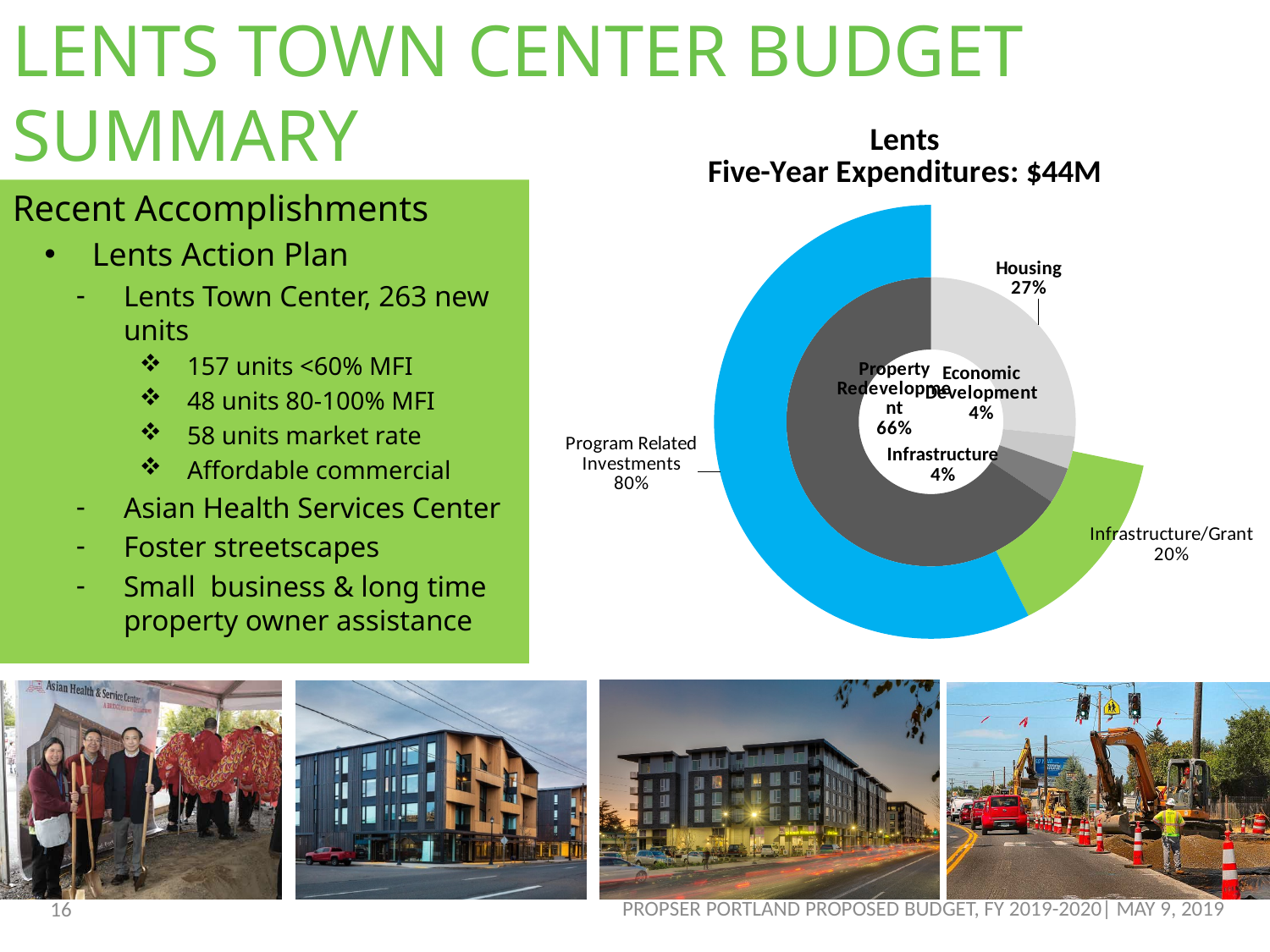
Which category in the outer ring has the smaller share? Infrastructure/Grant What is the difference in percentage points between Program Related Investments and Infrastructure/Grant in the outer ring? 60 What percentage is shown for Housing in the inner ring? 27% Which is larger in the inner ring, Housing or Infrastructure? Housing What kind of chart is shown on the slide? doughnut chart What percentage is shown for Property Redevelopment in the inner ring? 66% What is the title of the chart? Lents Five-Year Expenditures: $44M How many categories are labelled in the inner ring? 4 What share of the outer ring is Program Related Investments? 80% What percentage is shown for Economic Development in the inner ring? 4% What share of the outer ring is Infrastructure/Grant? 20% Which category in the inner ring has the largest share? Property Redevelopment